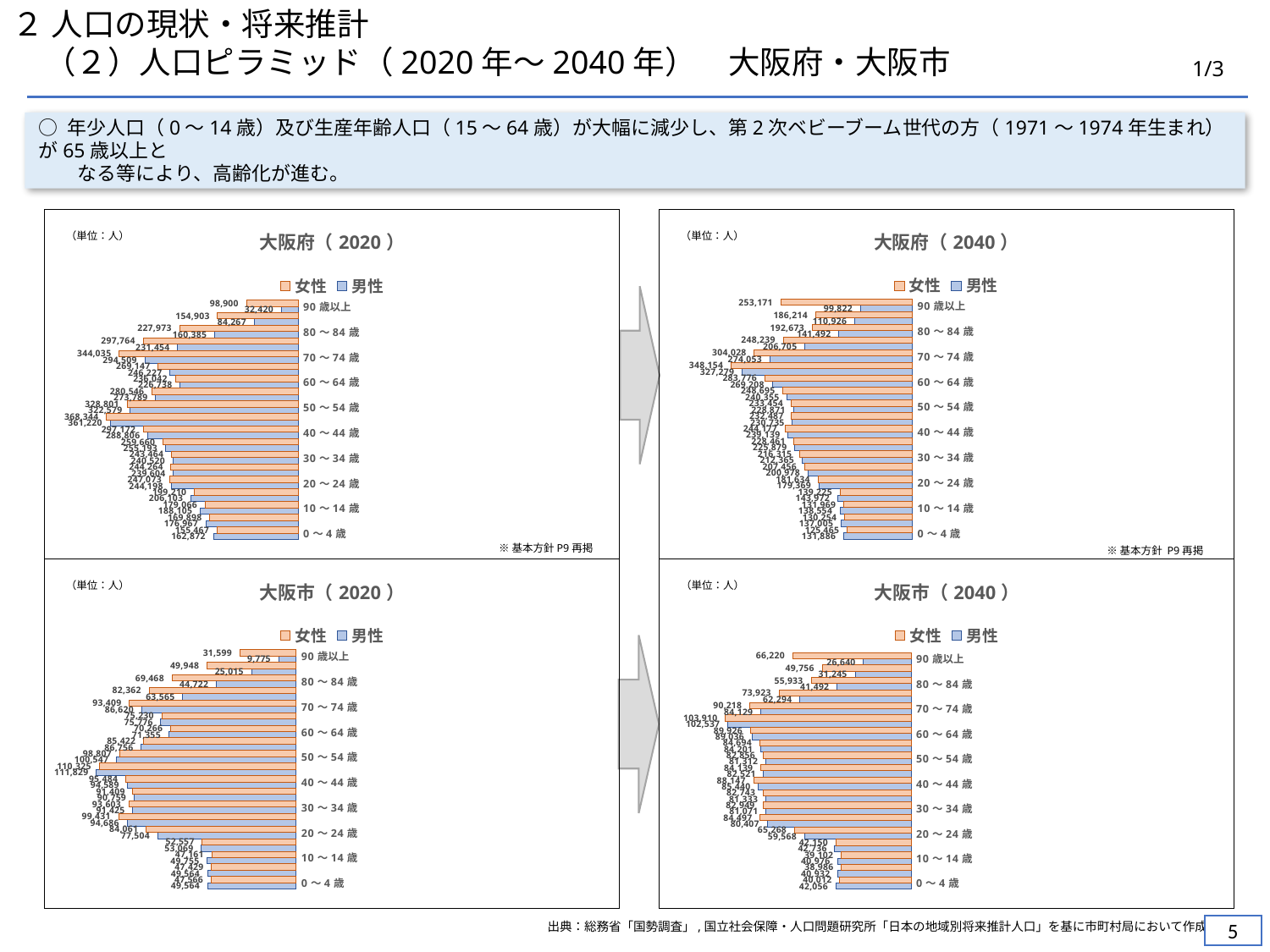
In the 大阪市（2020） chart, what is the 女性 value for 80～84歳? 69,468 What are the two legend entries in the 大阪市（2040） chart? 女性 and 男性 How many population pyramid charts are shown on the slide? 4 What kind of chart is the 大阪府（2020） chart? bar chart In the 大阪府（2020） chart, what is the 女性 value for 90歳以上? 98,900 How many series does the legend of the 大阪府（2020） chart list? 2 In the 大阪府（2040） chart, what is the 女性 value for 90歳以上? 253,171 In the 大阪府（2040） chart, what is the difference between the 女性 and 男性 values for 90歳以上? 153,349 In the 大阪市（2020） chart, what is the difference between the 女性 and 男性 values for 90歳以上? 21,824 In the 大阪市（2020） chart, which is larger for 90歳以上, 女性 or 男性? 女性 In the 大阪市（2040） chart, what is the 男性 value for 90歳以上? 26,640 In the 大阪府（2020） chart, what is the 男性 value for 90歳以上? 32,420